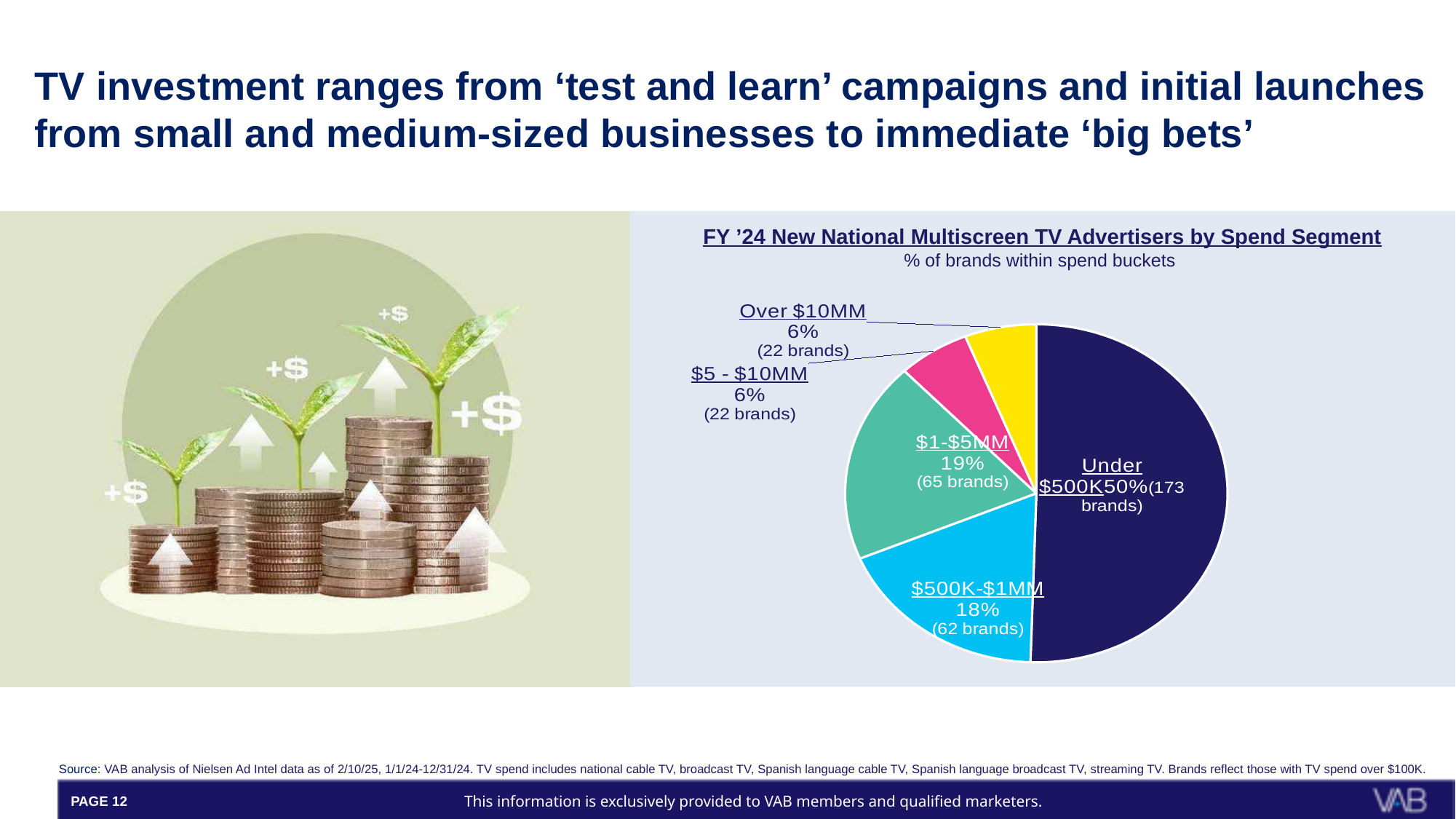
How many brands are in the $1-$5MM spend segment? 65 brands Which spend segment has the largest share of brands? Under $500K What percentage of brands is in the $500K-$1MM segment? 18% What type of chart is used to show new national multiscreen TV advertisers by spend segment? Pie chart What is the title of the chart on the slide? FY '24 New National Multiscreen TV Advertisers by Spend Segment What colour is the Under $500K slice of the pie chart? Dark navy blue What is the difference in percentage points between the Under $500K segment and the $1-$5MM segment? 31 percentage points Which segment has a larger share of brands, $1-$5MM or $500K-$1MM? $1-$5MM How many more brands are in the $1-$5MM segment than in the $500K-$1MM segment? 3 brands How many spend segments are shown in the pie chart? 5 What share of brands falls in the Under $500K spend segment? 50% How many brands are in the Over $10MM segment? 22 brands